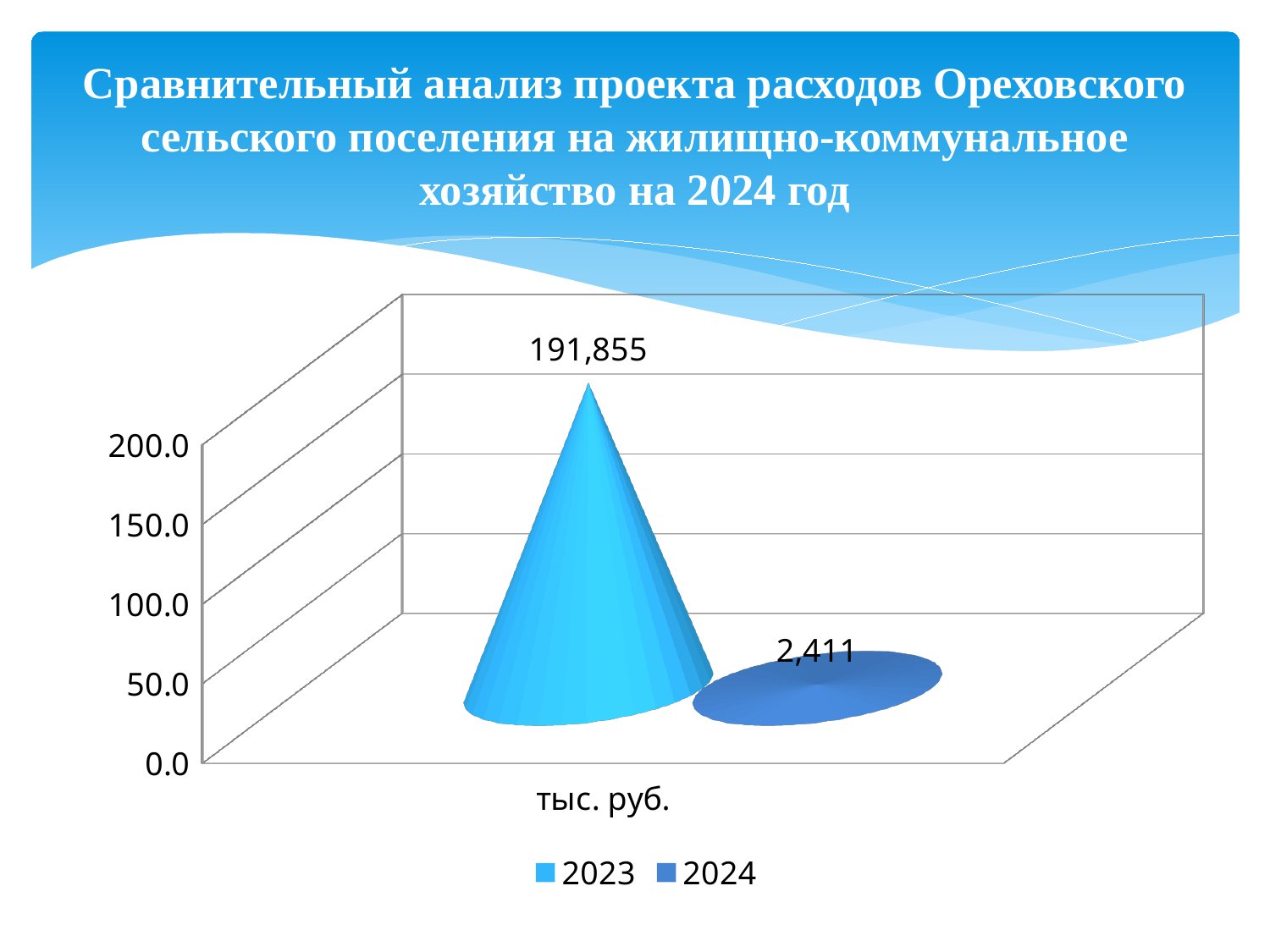
Which series has the lowest value on the chart? 2024 Is the value for 2023 greater or less than 150.0? greater Which series has the highest value on the chart? 2023 Do the expenditures rise or fall from 2023 to 2024? fall What label is shown on the category axis of the chart? тыс. руб. How many categories are shown on the x axis of the chart? 1 What is the value for the 2023 series on the chart? 191,855 Which is larger, the value for 2023 or the value for 2024? 2023 What is the difference between the 2023 value and the 2024 value? 189,444 How many series does the legend list? 2 Is the value for 2024 greater or less than 50.0? less What is the value for the 2024 series on the chart? 2,411